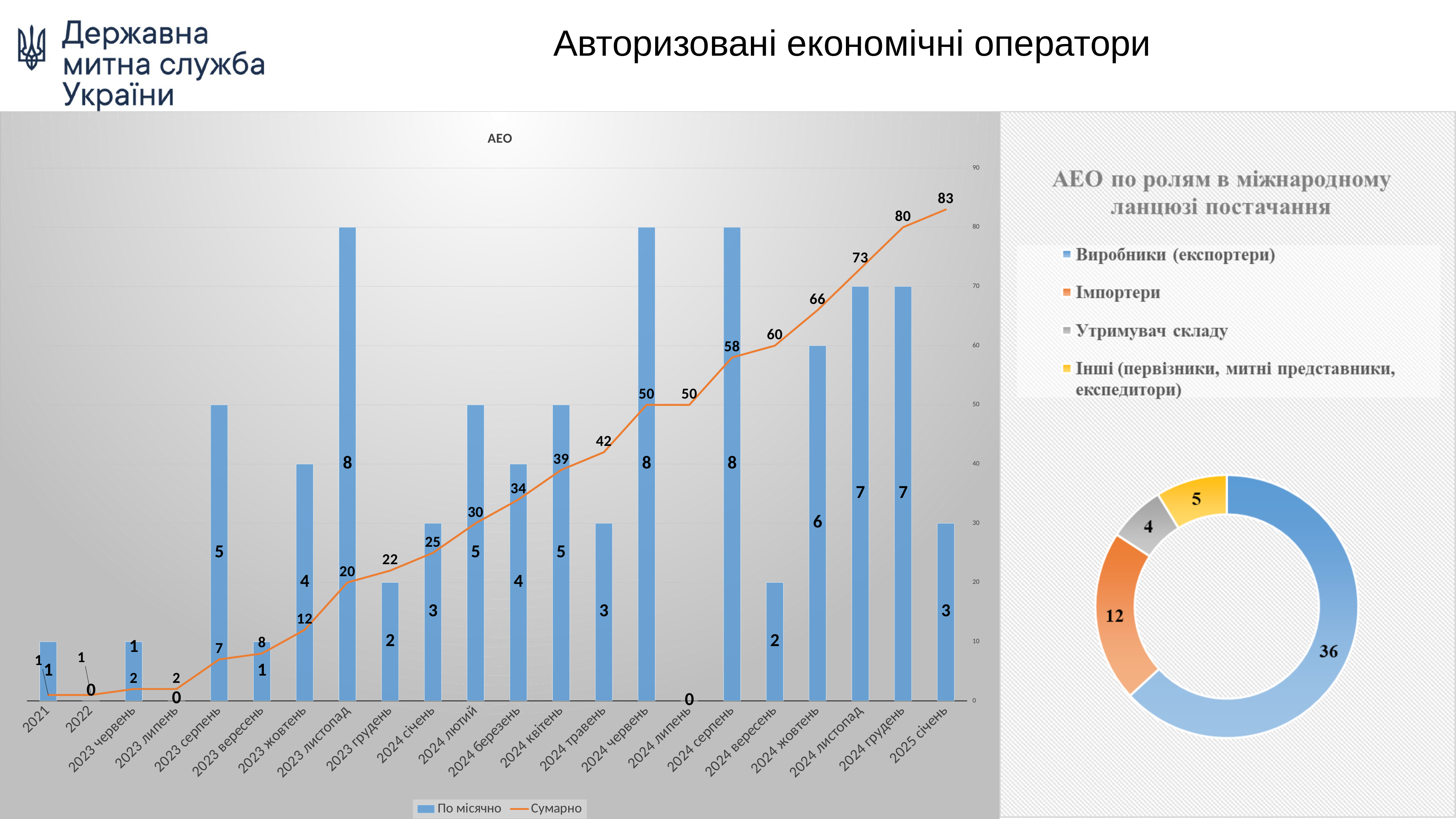
On the left chart titled АЕО, does the Сумарно line rise or fall from 2021 to 2025 січень? Rises On the right chart titled АЕО по ролям в міжнародному ланцюзі постачання, what is the value for Виробники (експортери)? 36 On the right chart titled АЕО по ролям в міжнародному ланцюзі постачання, which category has the smallest value? Утримувач складу On the left chart titled АЕО, what is the По місячно value for 2023 листопад? 8 On the left chart titled АЕО, which category has the highest Сумарно value? 2025 січень On the left chart titled АЕО, how many series does the legend list? 2 On the right chart titled АЕО по ролям в міжнародному ланцюзі постачання, what kind of chart is it? A doughnut chart On the left chart titled АЕО, which is larger: the По місячно value for 2024 жовтень or for 2024 вересень? 2024 жовтень On the left chart titled АЕО, what is the difference between the Сумарно values for 2024 грудень and 2024 листопад? 7 On the left chart titled АЕО, what kind of chart is it? A combined bar and line chart On the left chart titled АЕО, what is the Сумарно value for 2024 червень? 50 On the left chart titled АЕО, how many categories are shown on the x axis? 22